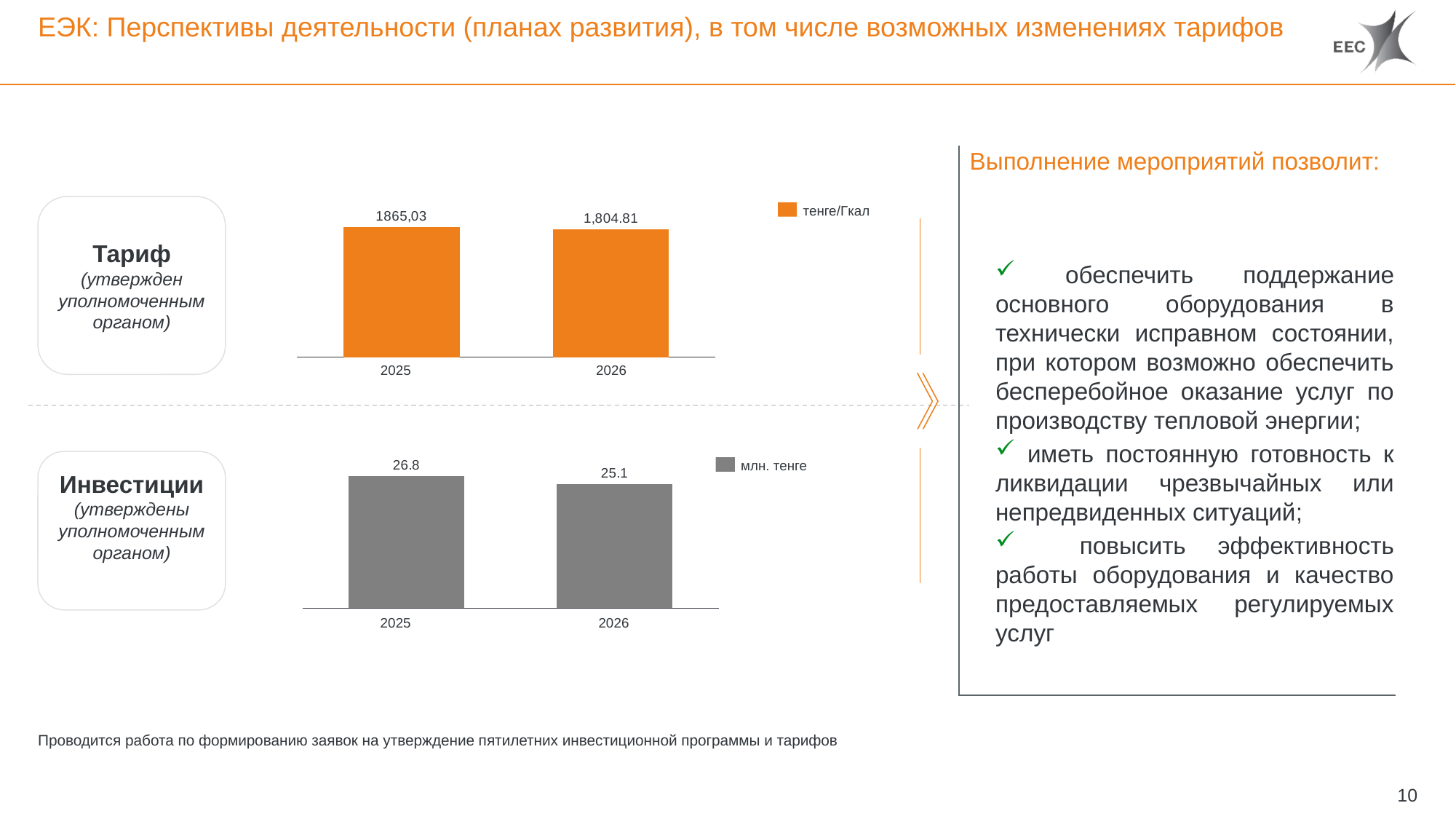
In the bottom chart (Инвестиции), what is the difference between the 2025 and 2026 values? 1.7 In the top chart (Тариф), which year has the lower value? 2026 What unit does the legend of the top chart (Тариф) show? тенге/Гкал In the bottom chart (Инвестиции), what is the value for 2026? 25.1 How many bars are shown in the bottom chart (Инвестиции)? 2 What type of chart is the top chart (Тариф)? bar chart In the bottom chart (Инвестиции), do the values rise or fall from 2025 to 2026? fall In the top chart (Тариф), is the value for 2025 larger or smaller than the value for 2026? larger In the top chart (Тариф), what is the value for 2026? 1,804.81 In the top chart (Тариф), what is the value for 2025? 1865,03 In the bottom chart (Инвестиции), which year has the higher value? 2025 In the bottom chart (Инвестиции), what is the value for 2025? 26.8